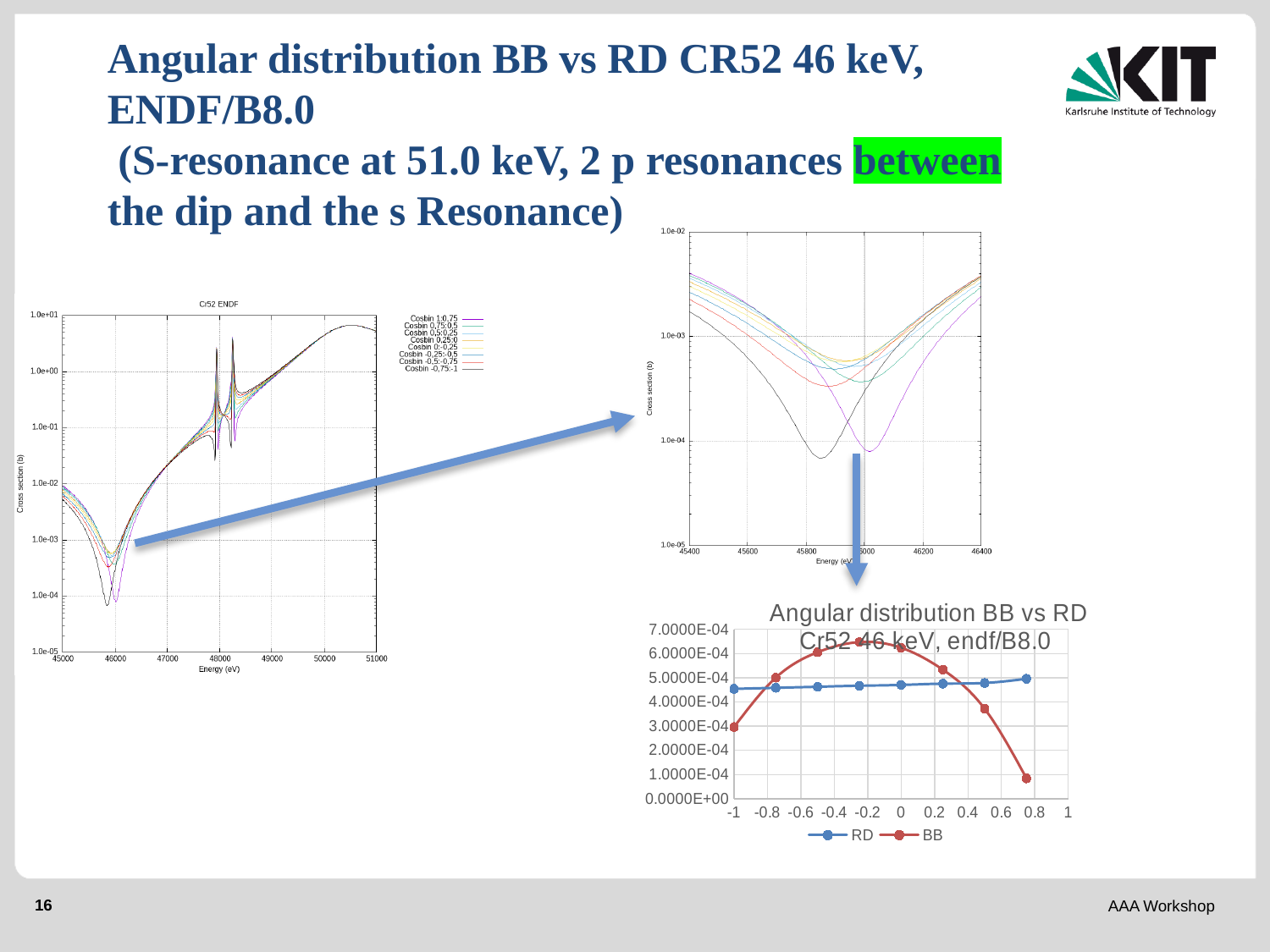
In the bottom-right chart 'Angular distribution BB vs RD', do the BB values rise or fall as x goes from 0 to 0.75? fall In the bottom-right chart 'Angular distribution BB vs RD', is the BB value at x = -1 greater or less than 4.0000E-04? less In the bottom-right chart 'Angular distribution BB vs RD', is the BB value at x = 0.75 greater or less than 2.0000E-04? less What are the two series named in the legend of the bottom-right chart 'Angular distribution BB vs RD'? RD and BB In the bottom-right chart 'Angular distribution BB vs RD', which series has the larger value at x = 0, RD or BB? BB How many series does the legend of the bottom-right chart 'Angular distribution BB vs RD' list? 2 In the bottom-right chart 'Angular distribution BB vs RD', is the BB value at x = -0.25 greater or less than 6.0000E-04? greater In the bottom-right chart 'Angular distribution BB vs RD', which series has the larger value at x = 0.75, RD or BB? RD In the bottom-right chart 'Angular distribution BB vs RD', how many data points are plotted for the BB series? 8 In the bottom-right chart 'Angular distribution BB vs RD', which series reaches the highest value on the chart? BB What kind of chart is the bottom-right chart titled 'Angular distribution BB vs RD Cr52 46 keV, endf/B8.0'? line chart